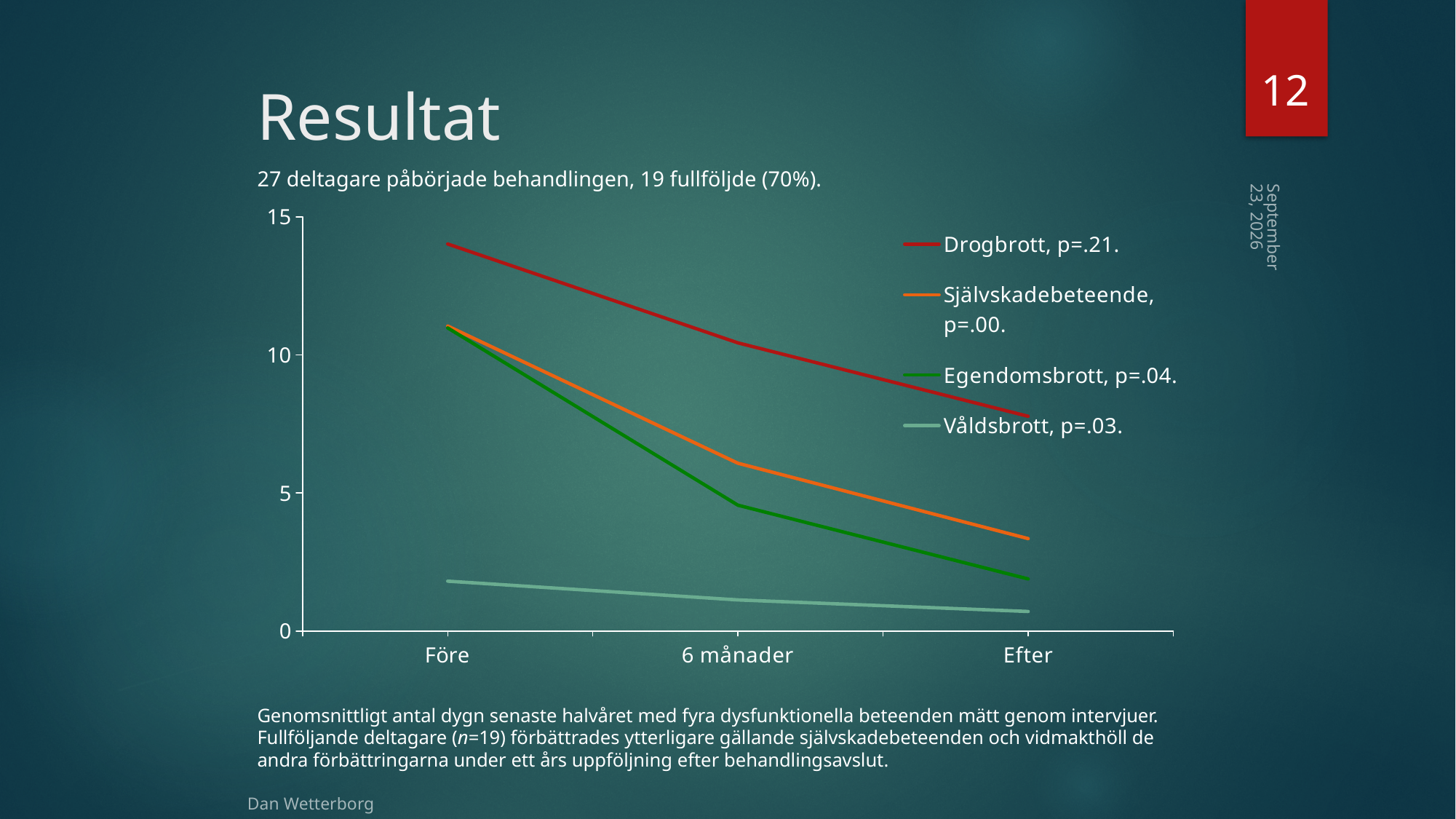
Do the values for Drogbrott rise or fall from "Före" to "Efter"? fall Which series has the highest value at "Före"? Drogbrott, p=.21. How many points are there along the x axis? 3 Is the value for Drogbrott at "Efter" greater or less than 5? greater At "6 månader", which is larger: the value for Självskadebeteende or the value for Egendomsbrott? Självskadebeteende Which series has the lowest value at "Efter"? Våldsbrott, p=.03. Is the value for Självskadebeteende at "Efter" greater or less than 5? less What kind of chart is shown on the slide? line chart How many series does the legend list? 4 What are the labels on the x axis? Före, 6 månader, Efter Is the value for Drogbrott at "Före" greater or less than 10? greater